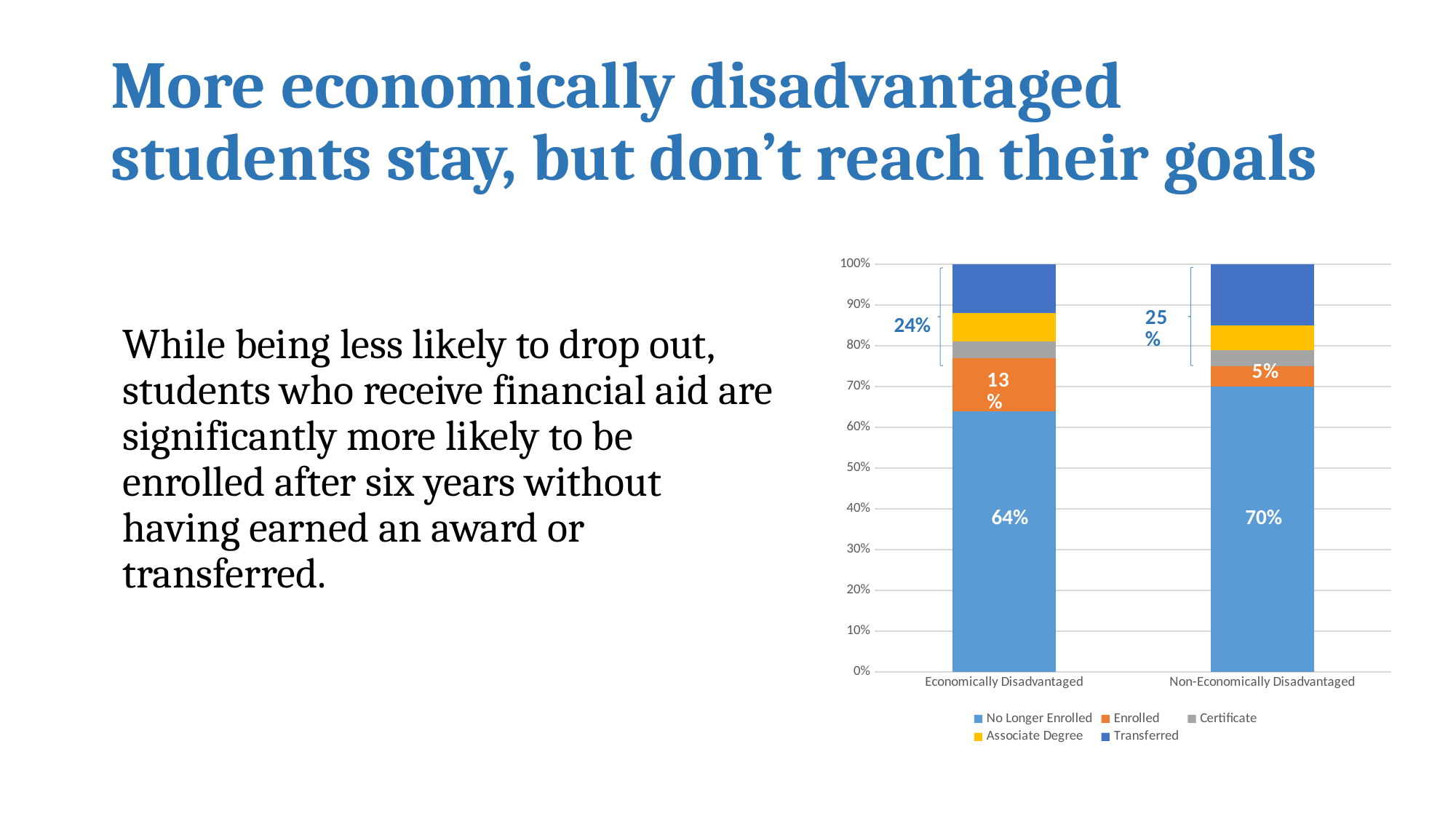
What is the value of the No Longer Enrolled segment for Economically Disadvantaged students? 64% What is the value of the Enrolled segment for Economically Disadvantaged students? 13% What is the value of the No Longer Enrolled segment for Non-Economically Disadvantaged students? 70% What kind of chart is shown on the slide? Stacked bar chart How many series does the chart legend list? 5 How many categories are shown on the x axis of the chart? 2 What is the difference between the Enrolled shares of Economically Disadvantaged and Non-Economically Disadvantaged students? 8 percentage points Which category has the larger No Longer Enrolled share, Economically Disadvantaged or Non-Economically Disadvantaged? Non-Economically Disadvantaged Which category has the larger Enrolled share, Economically Disadvantaged or Non-Economically Disadvantaged? Economically Disadvantaged Is the Transferred segment for Non-Economically Disadvantaged students greater or less than 10%? greater What is the difference between the No Longer Enrolled shares of Non-Economically Disadvantaged and Economically Disadvantaged students? 6 percentage points What is the value of the Enrolled segment for Non-Economically Disadvantaged students? 5%